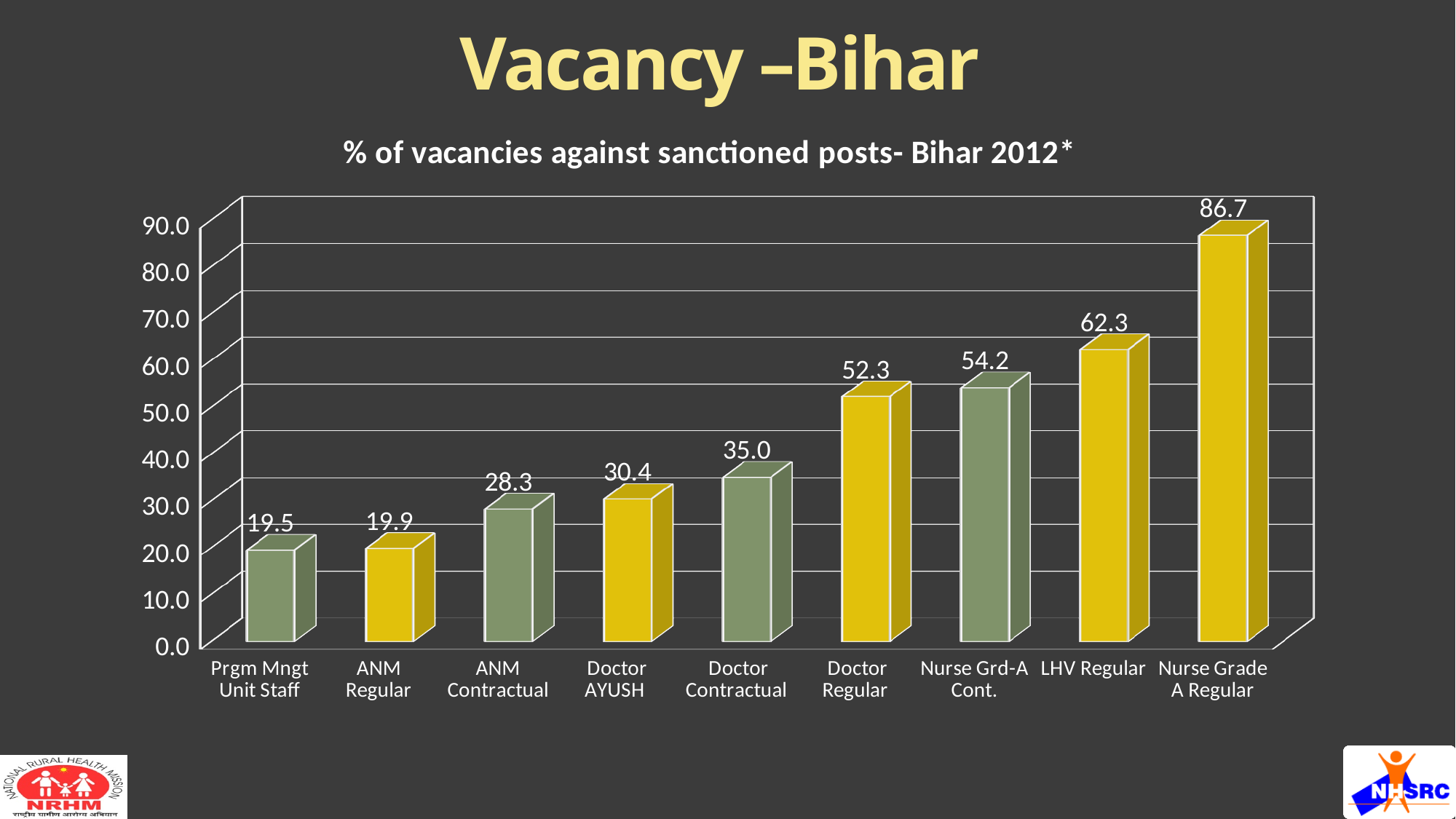
Which is larger, the value for Nurse Grd-A Cont. or the value for Doctor Regular? Nurse Grd-A Cont. What is the difference between the values for Doctor Contractual and Doctor AYUSH? 4.6 What is the value for ANM Contractual? 28.3 Which category has the highest value? Nurse Grade A Regular What is the value for LHV Regular? 62.3 How many categories are shown on the x axis? 9 Is the value for Doctor Contractual greater or less than 40.0? less What is the value for Doctor Regular? 52.3 What is the title of the chart? % of vacancies against sanctioned posts- Bihar 2012* What kind of chart is shown on the slide? bar chart Which category has the lowest value? Prgm Mngt Unit Staff What is the difference between the values for Nurse Grade A Regular and LHV Regular? 24.4